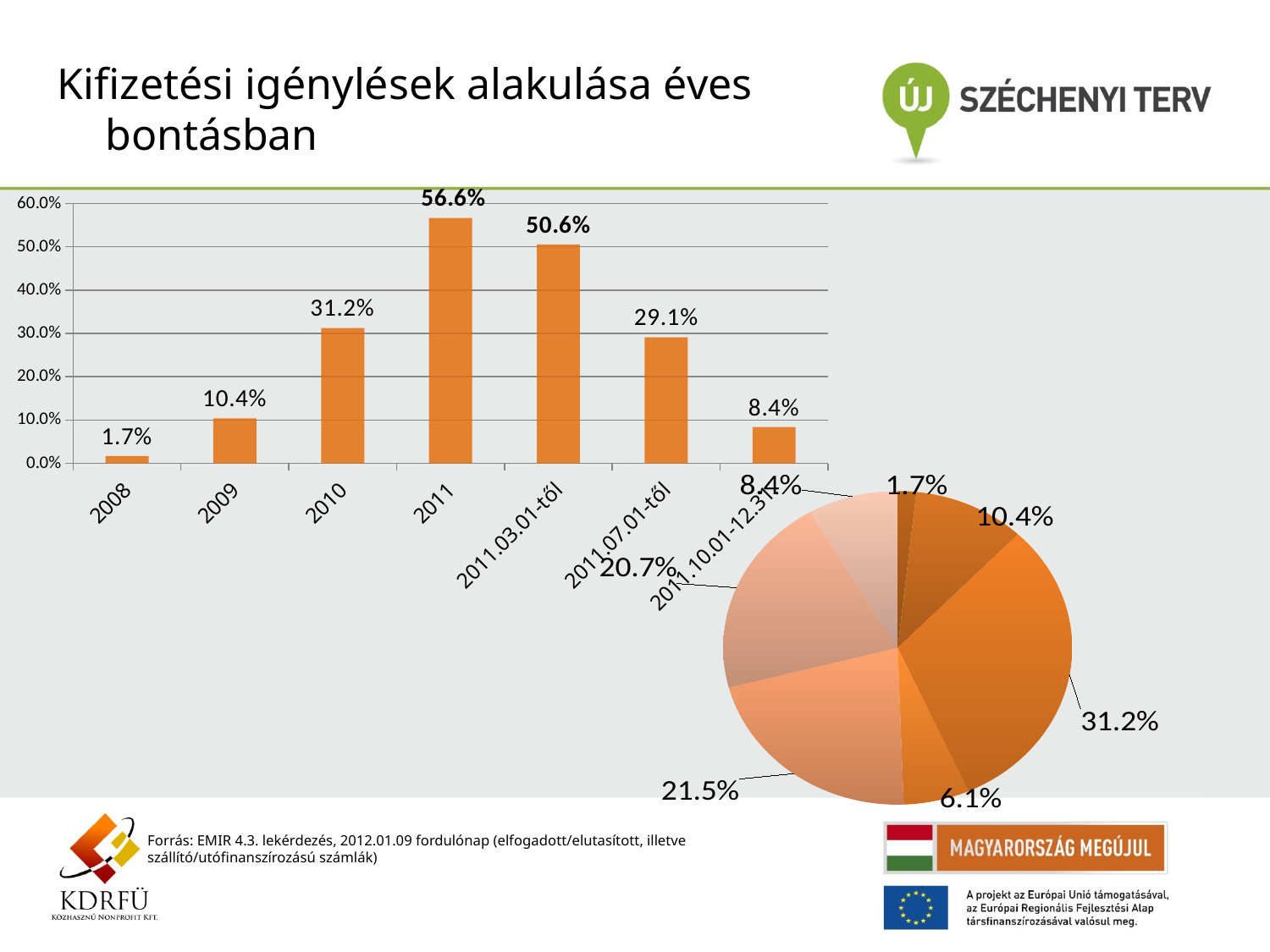
In the bar chart, do the values rise or fall from 2008 to 2011? rise In the bar chart, what is the difference between the values for 2011 and 2011.03.01-től? 6.0% In the bar chart, what is the value for 2009? 10.4% In the bar chart, what is the value for 2011.07.01-től? 29.1% In the bar chart, which is larger, the value for 2010 or the value for 2011.07.01-től? 2010 What kind of chart is the chart at the top of the slide? bar chart How many categories are shown in the bar chart? 7 In the bar chart, which category has the lowest value? 2008 In the bar chart, which category has the highest value? 2011 In the bar chart, what is the value for 2011? 56.6% In the pie chart, what is the largest labelled share? 31.2% In the bar chart, is the value for 2011.03.01-től greater or less than 40.0%? greater